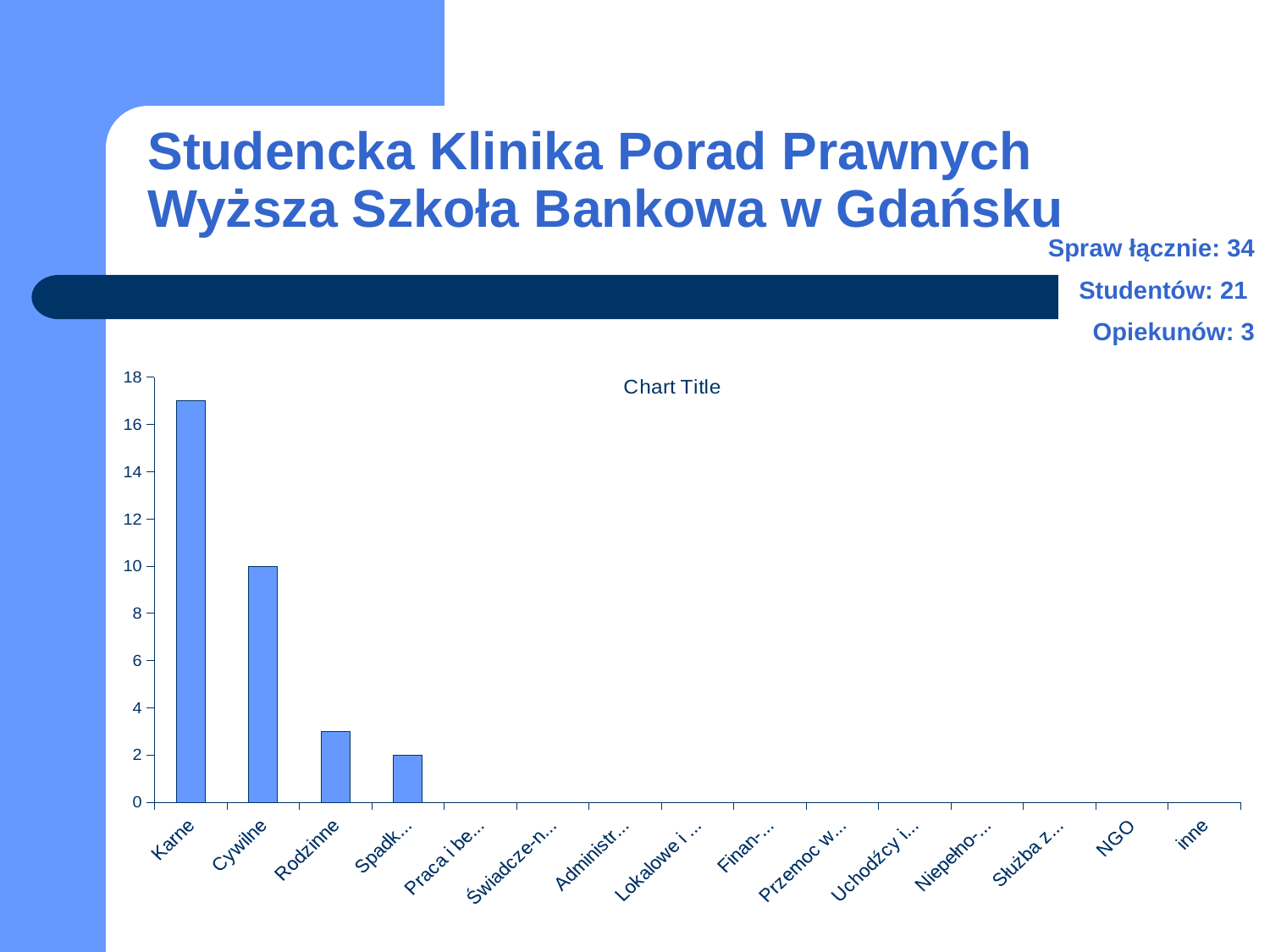
Is the value for Rodzinne greater or less than 4? less Do the bar values rise or fall moving from left to right along the x axis? fall What kind of chart is shown on the slide? bar chart Is the value for Rodzinne greater or less than 2? greater What is the value for Cywilne? 10 How many categories are shown on the x axis of the chart? 15 Which category has the highest value in the chart? Karne What is the highest value shown on the vertical axis of the chart? 18 Is the value for Karne greater or less than 16? greater Which is larger, the value for Cywilne or the value for Rodzinne? Cywilne Which is larger, the value for Karne or the value for Cywilne? Karne What is the title shown on the chart? Chart Title